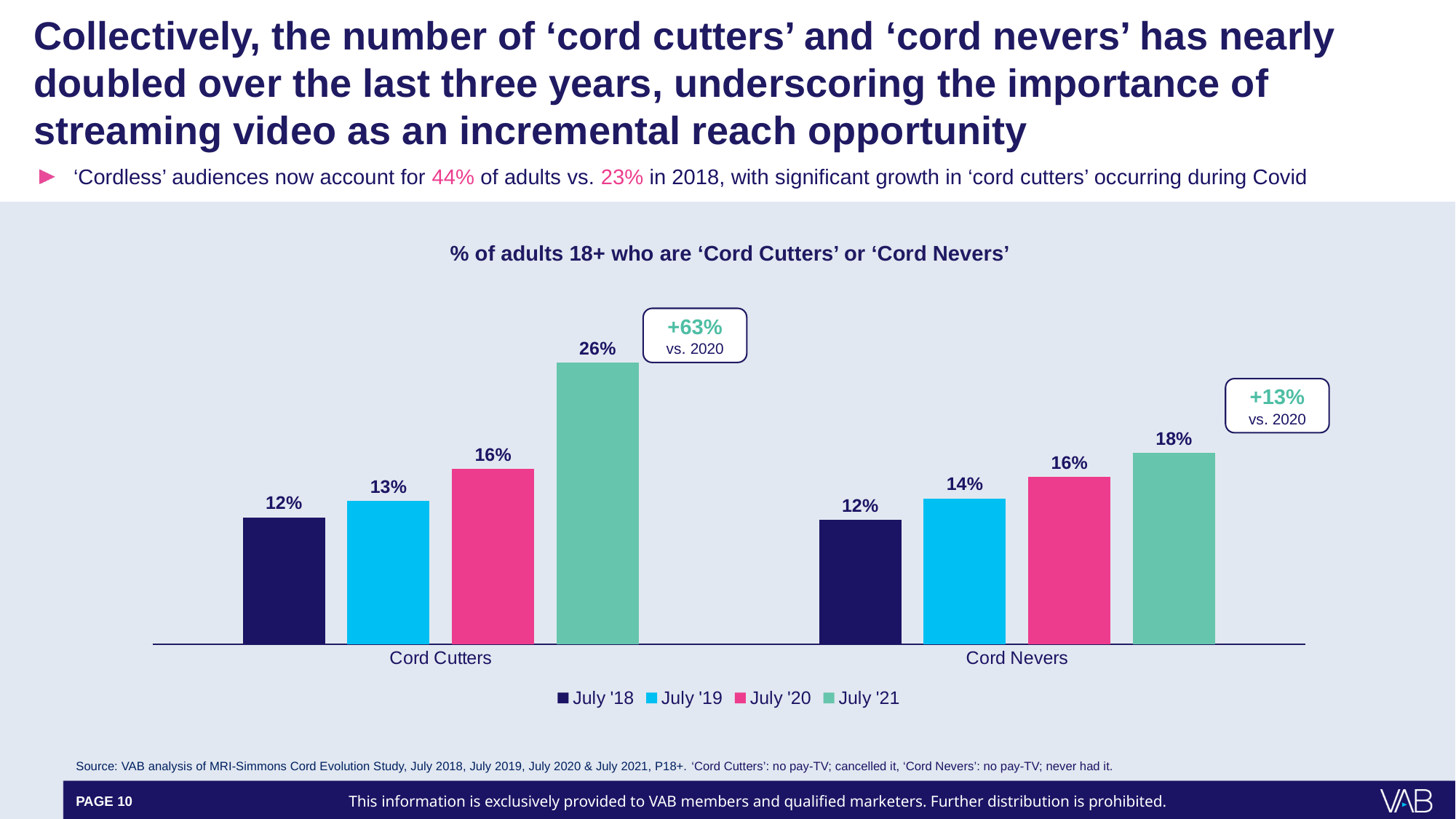
Do the values for Cord Nevers rise or fall from July '18 to July '21? Rise How many categories are shown on the x axis? 2 What is the difference between the July '21 values for Cord Cutters and Cord Nevers? 8% Which series has the highest value for Cord Nevers? July '21 What is the value for Cord Nevers in July '19? 14% What is the difference between the July '21 and July '20 values for Cord Cutters? 10% Which is larger: the July '19 value for Cord Cutters or the July '19 value for Cord Nevers? Cord Nevers What kind of chart is shown on the slide? Bar chart What is the value for Cord Cutters in July '18? 12% Which series has the lowest value for Cord Cutters? July '18 How many series does the legend list? 4 What is the value for Cord Cutters in July '21? 26%